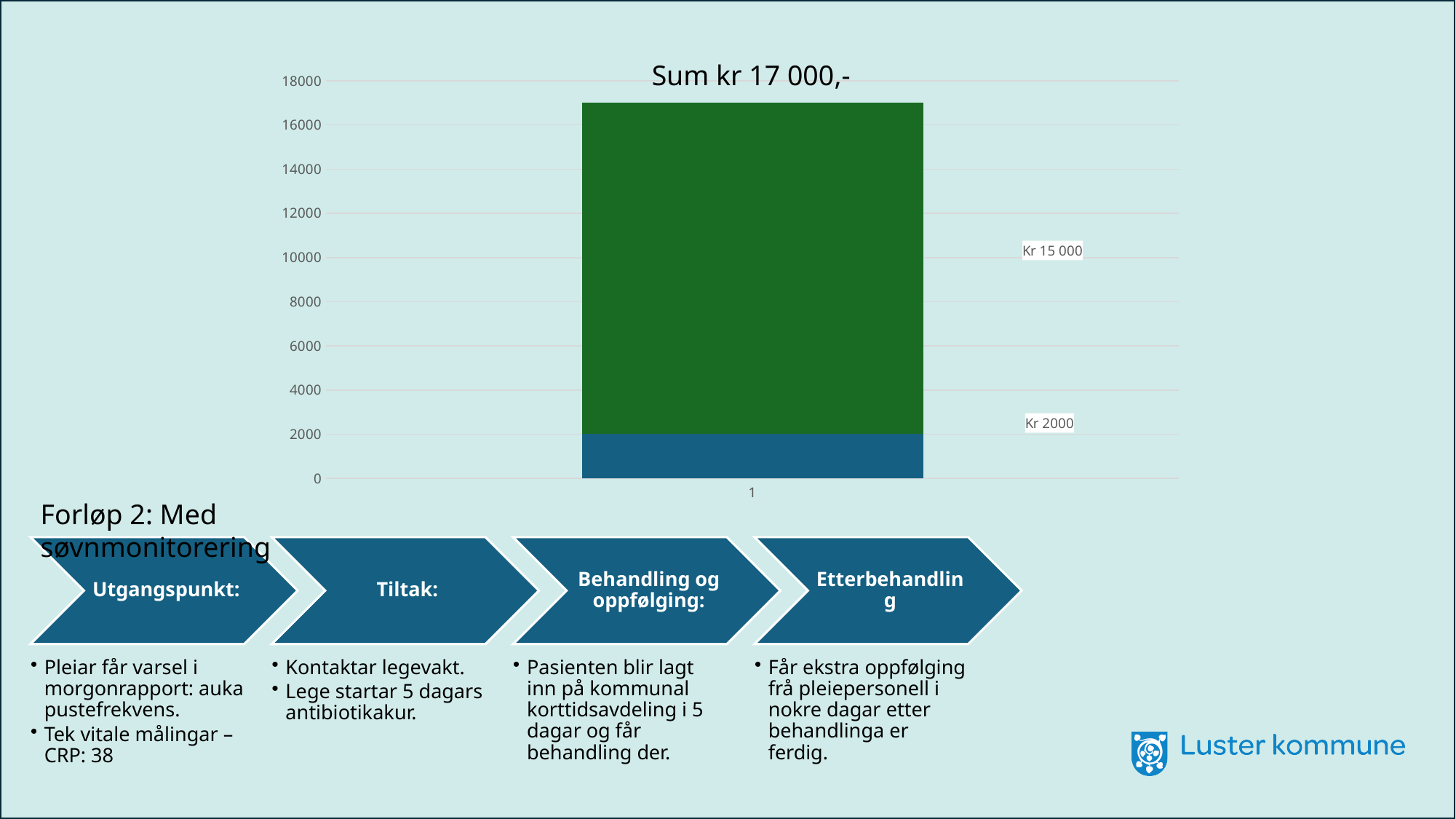
Is the total height of the bar greater or less than 16000? greater What is the category label shown on the horizontal axis? 1 Is the blue segment of the bar greater or less than 4000? less What is the value of the green segment of the bar? Kr 15 000 Which segment of the bar is larger, the green one or the blue one? the green one What kind of chart is shown on the slide? stacked bar chart What is the total of the stacked bar? kr 17 000,- What is the value of the blue segment of the bar? Kr 2000 What is the title of the chart? Sum kr 17 000,- What is the highest value shown on the vertical axis? 18000 What is the difference between the green segment (Kr 15 000) and the blue segment (Kr 2000)? 13 000 How many bars does the chart contain? 1